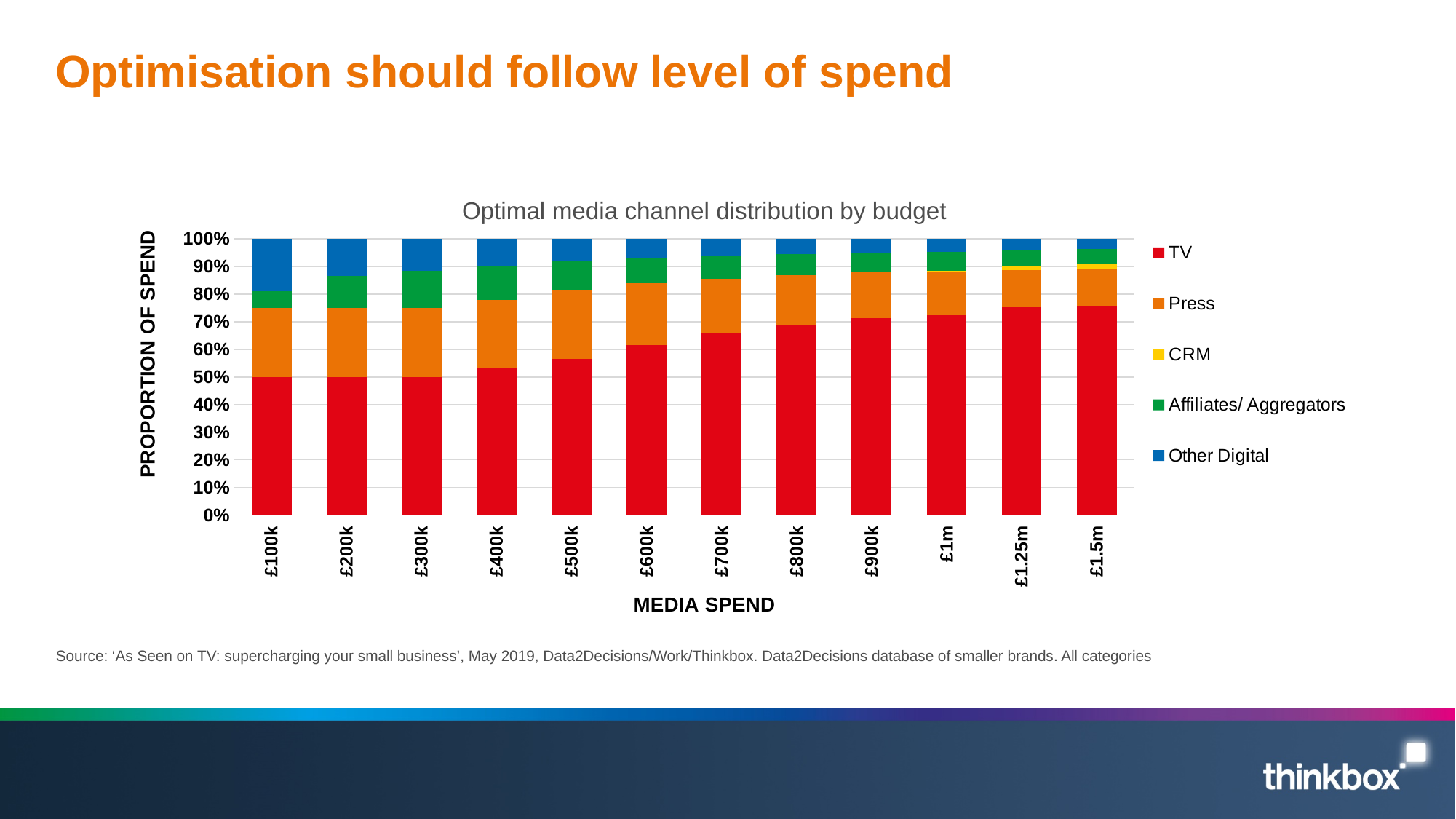
Does the TV proportion of spend rise or fall as media spend increases along the x axis? Rise What is the TV proportion of spend at £100k? 50% Is the TV proportion of spend at £1.25m greater or less than 70%? greater How many media spend levels are shown on the x axis? 12 Is the TV proportion of spend at £400k greater or less than 60%? less Which has a larger Other Digital proportion of spend, £100k or £1.5m? £100k What is the title of the chart? Optimal media channel distribution by budget What is the label of the x axis? MEDIA SPEND How many series does the legend list? 5 What kind of chart is shown on the slide? Stacked bar chart Which has a larger TV proportion of spend, £100k or £1.5m? £1.5m Is the TV proportion of spend at £1.5m greater or less than 70%? greater